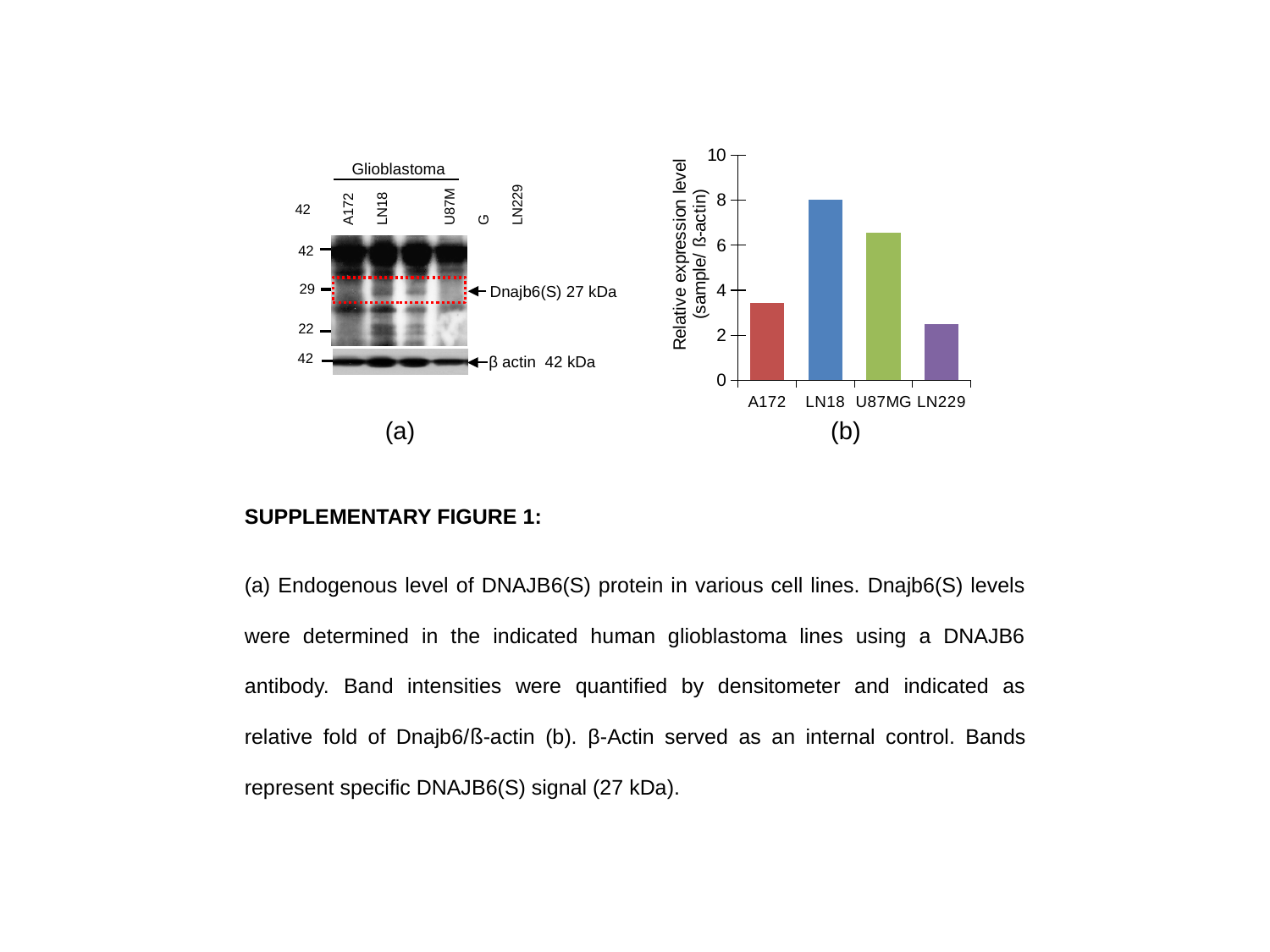
In chart (b), is the relative expression level for A172 greater or less than 4? less In chart (b), which cell line has the lowest relative expression level? LN229 In chart (b), is the relative expression level for U87MG greater or less than 6? greater How many cell lines are plotted in chart (b)? 4 In chart (b), is the relative expression level for LN229 greater or less than 2? greater What is the maximum value shown on the y-axis of chart (b)? 10 What is the y-axis label of chart (b)? Relative expression level (sample/ ß-actin) In chart (b), which cell line has the highest relative expression level? LN18 In chart (b), which has a higher relative expression level, LN18 or LN229? LN18 What kind of chart is chart (b) on the slide? bar chart In chart (b), which has a higher relative expression level, A172 or U87MG? U87MG